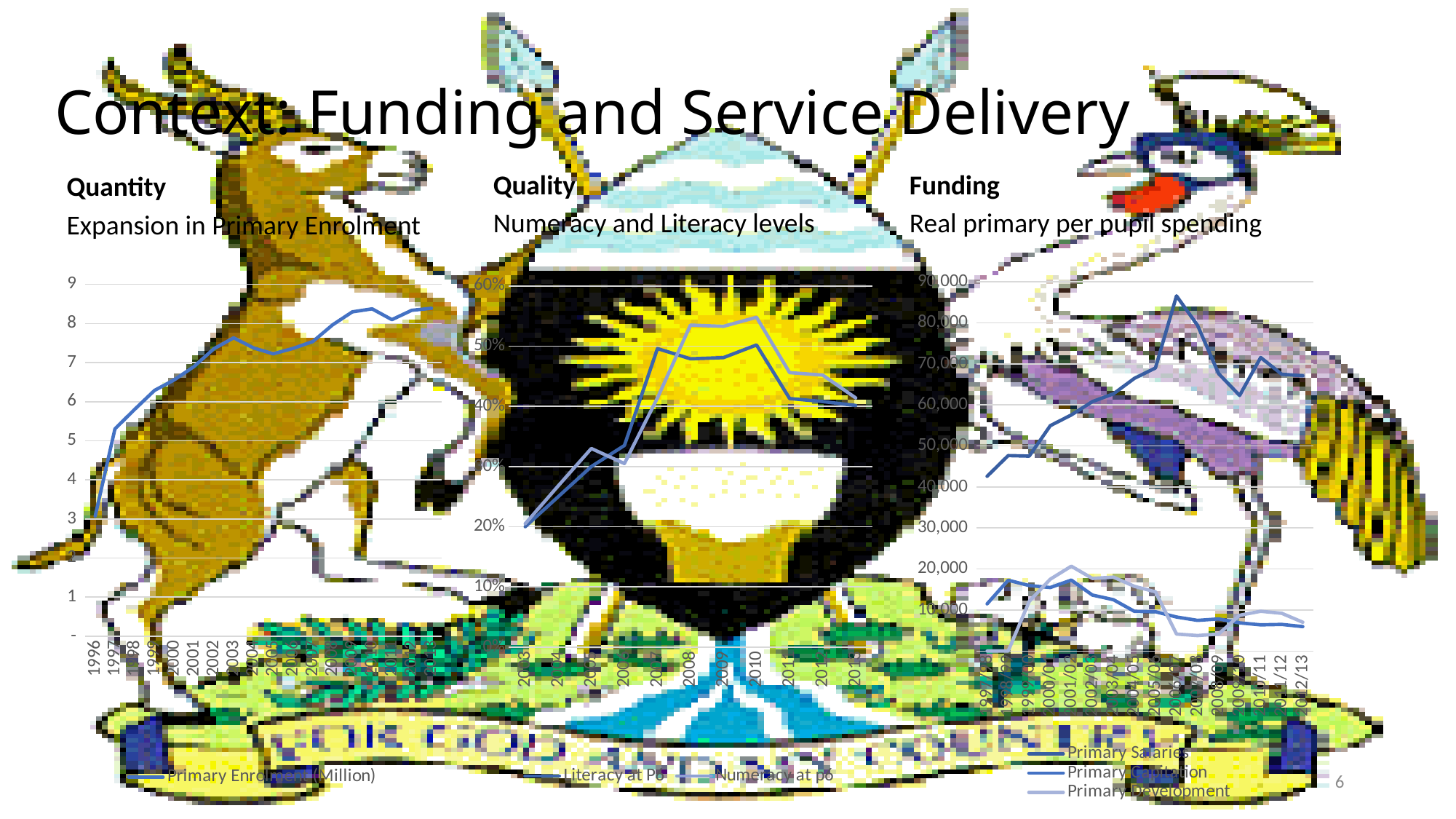
In the right 'Real primary per pupil spending' chart, is the peak value of Primary Salaries greater or less than 80,000? greater In the left 'Expansion in Primary Enrolment' chart, is the value for 1996 greater or less than 4? less What kind of chart is the 'Expansion in Primary Enrolment' chart on the left? line chart In the middle 'Numeracy and Literacy levels' chart, is the value for Literacy at P6 in 2003 greater or less than 30%? less How many series does the legend of the middle 'Numeracy and Literacy levels' chart list? 2 What is the title of the chart under the 'Funding' heading? Real primary per pupil spending In the left 'Expansion in Primary Enrolment' chart, do the values generally rise or fall from 1996 onwards? rise How many series does the legend of the right 'Real primary per pupil spending' chart list? 3 What is the legend entry of the left chart? Primary Enrolment (Million) In the right 'Real primary per pupil spending' chart, which series has the highest values? Primary Salaries In the right 'Real primary per pupil spending' chart, which is larger in 2012/13: Primary Salaries or Primary Development? Primary Salaries